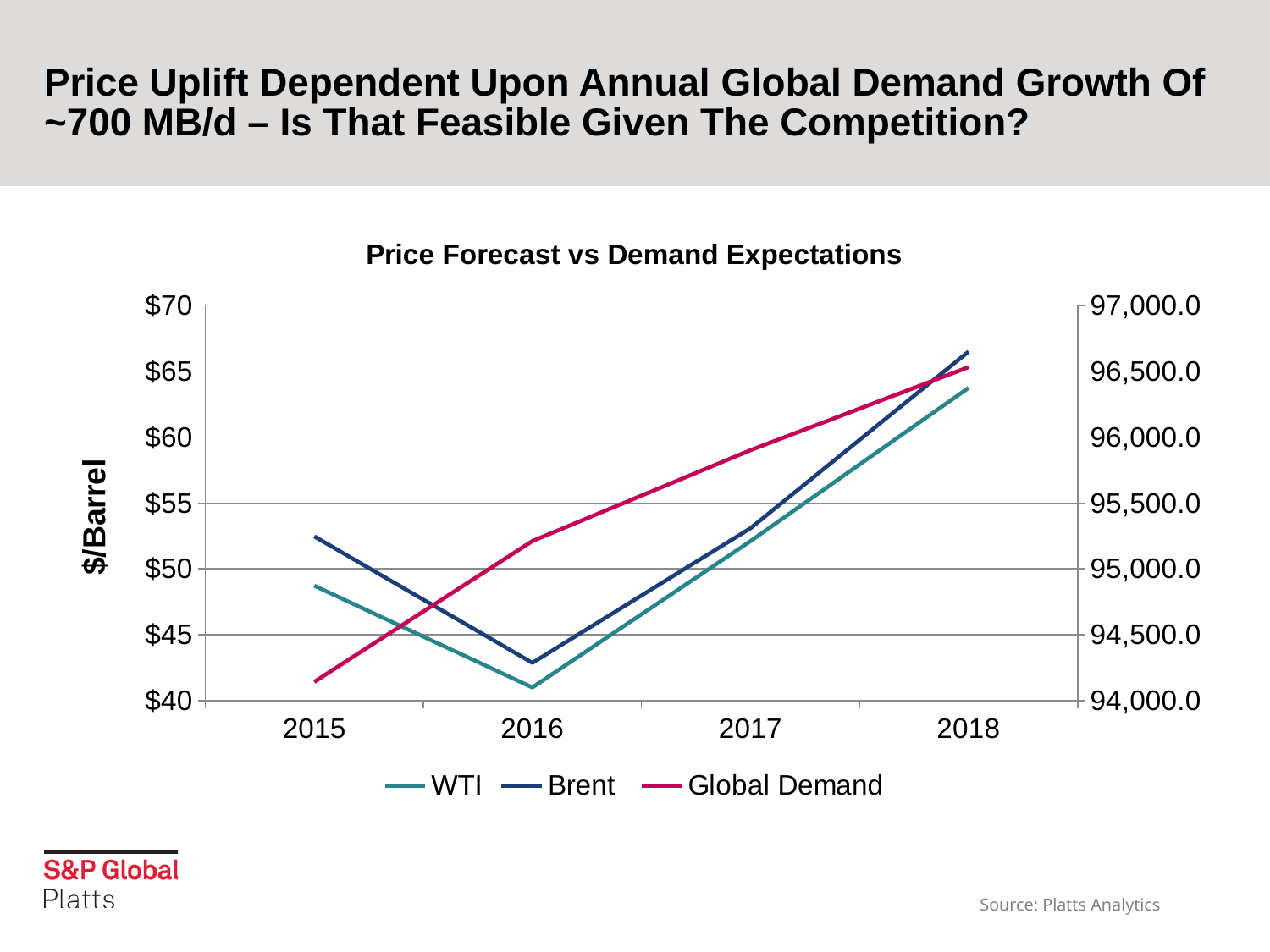
Is the Brent price in 2016 greater or less than $45? less In which year is the Brent price highest? 2018 In which year is the WTI price lowest? 2016 Is the Global Demand value in 2015 greater or less than 94,500.0? less How many series does the legend list? 3 Does the Global Demand line rise or fall from 2015 to 2018? rises What kind of chart is shown on the slide? line chart How many years are shown on the x axis? 4 What is the title of the chart? Price Forecast vs Demand Expectations In 2015, which is higher, the Brent price or the WTI price? Brent Is the WTI price in 2018 greater or less than $60? greater Which series are listed in the legend? WTI, Brent, Global Demand